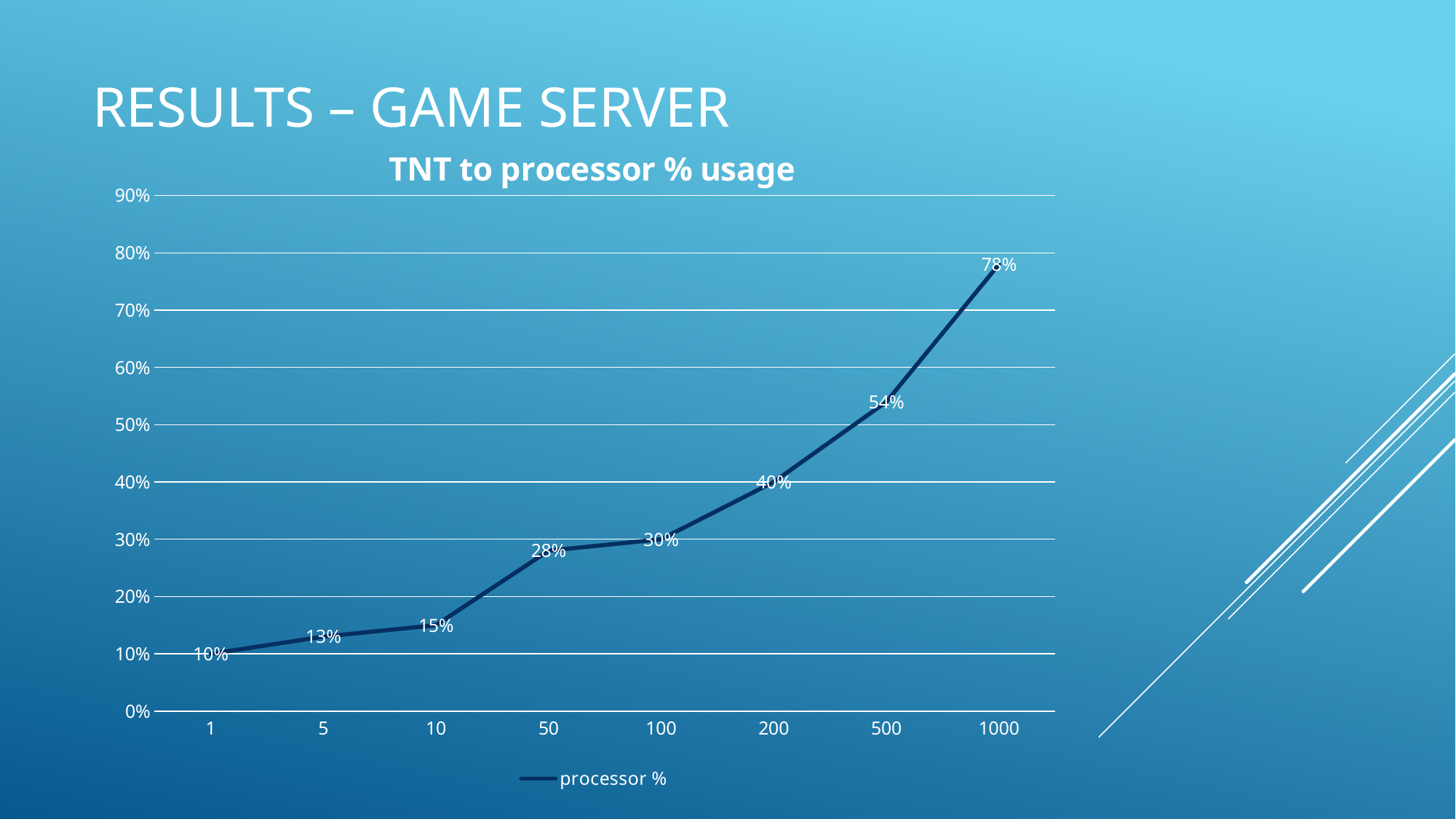
How many data points are plotted on the line? 8 What is the processor % usage at 1000 TNT? 78% What is the title of the chart? TNT to processor % usage How many series does the legend list? 1 At which TNT amount is processor % usage lowest? 1 Which has higher processor % usage: 100 TNT or 50 TNT? 100 What is the processor % usage at 5 TNT? 13% What is the processor % usage at 50 TNT? 28% Does processor % usage rise or fall as the TNT amount increases along the x axis? rise What kind of chart is shown? line chart At which TNT amount is processor % usage highest? 1000 What is the difference in processor % usage between 500 TNT and 200 TNT? 14%